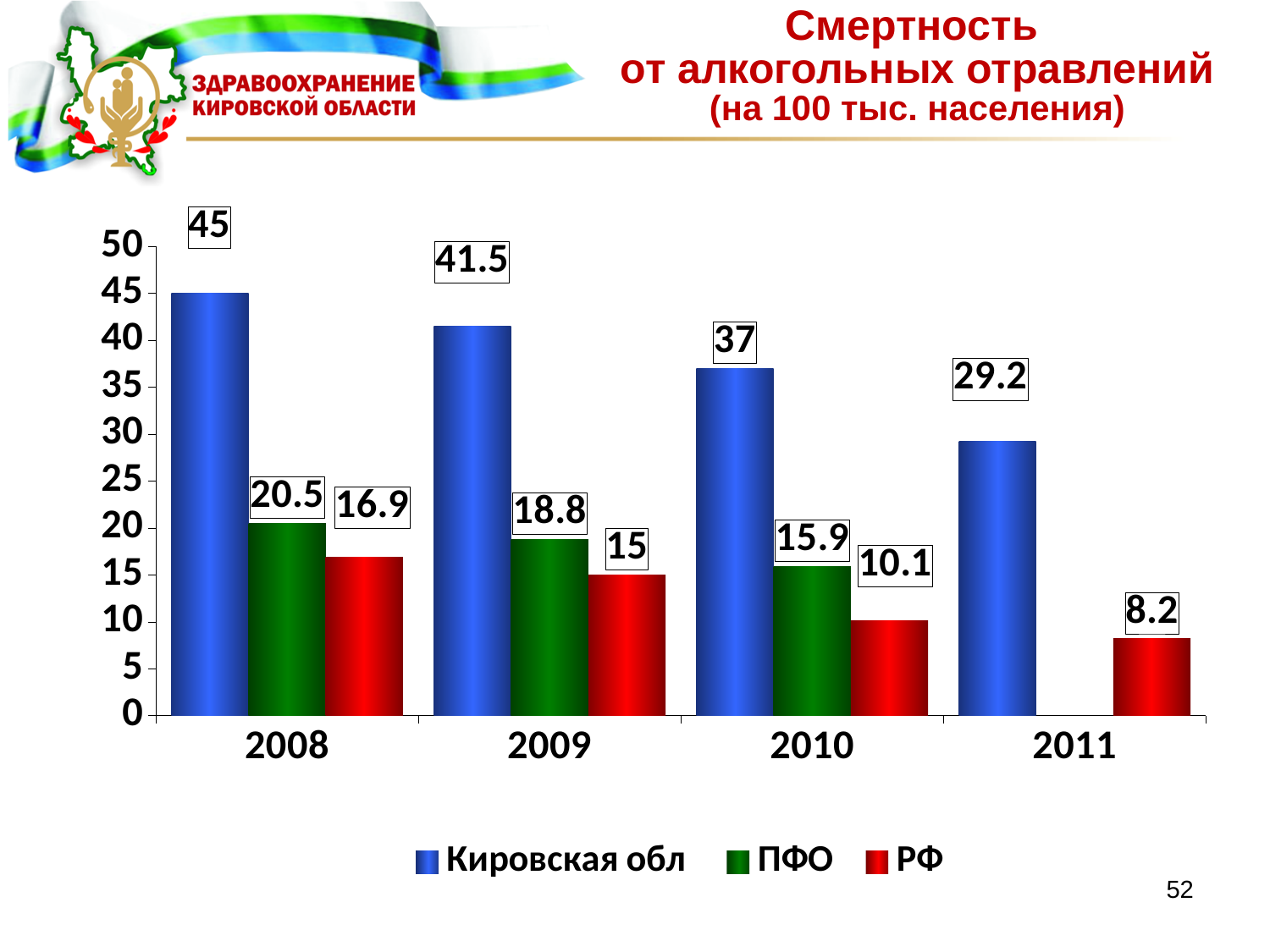
How many series does the legend list? 3 What is the value for РФ in 2011? 8.2 What is the value for ПФО in 2010? 15.9 In which year is the value for РФ lowest? 2011 Do the values for Кировская обл rise or fall from 2008 to 2011? fall In which year is the value for Кировская обл highest? 2008 Is the value for Кировская обл in 2011 greater or less than 30? less Which is larger in 2008: the value for ПФО or the value for РФ? ПФО What is the value for Кировская обл in 2009? 41.5 What kind of chart is shown on the slide? bar chart How many years are shown on the x axis? 4 What is the difference between the Кировская обл and РФ values in 2010? 26.9